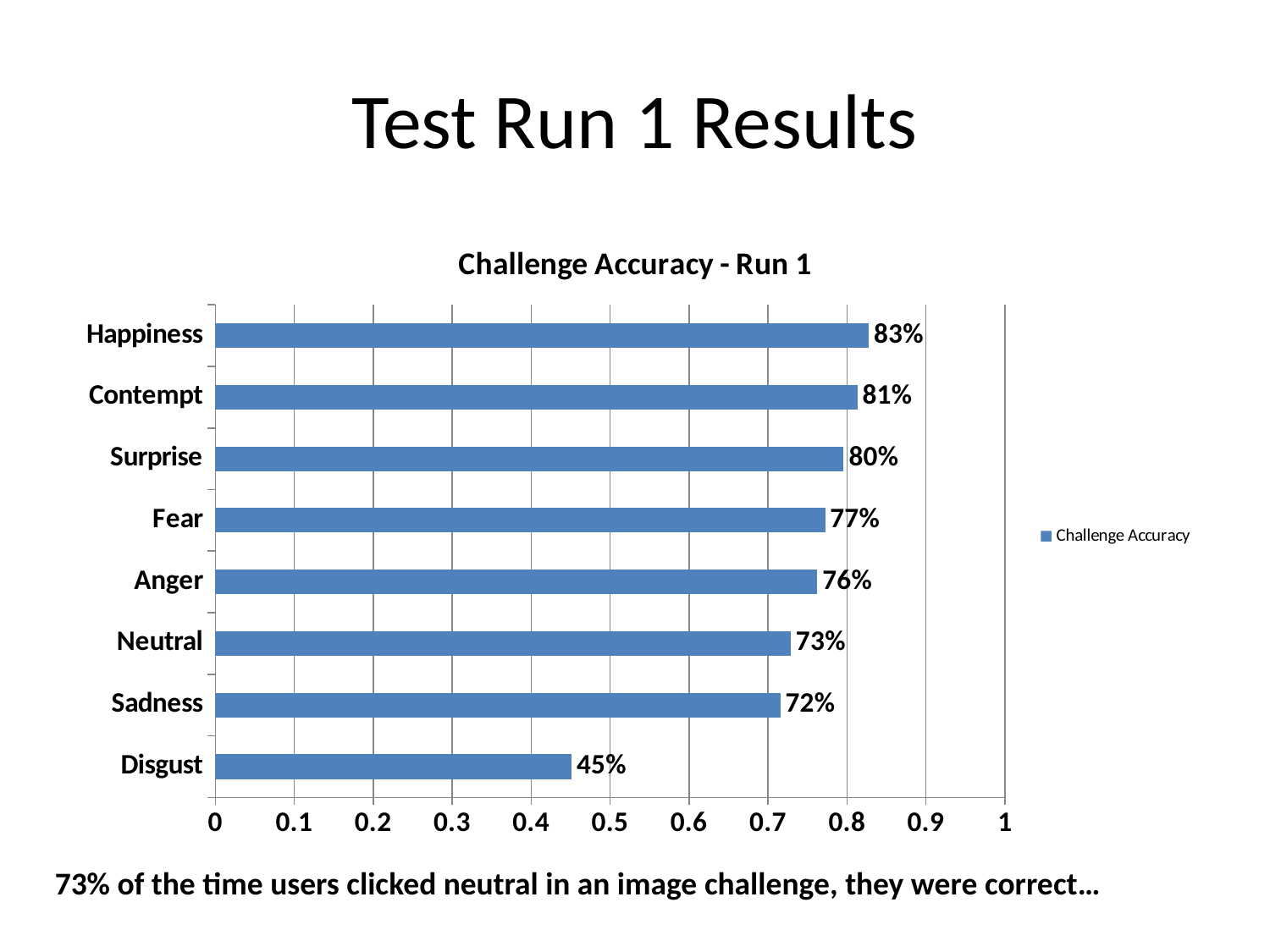
Which emotion has the highest Challenge Accuracy? Happiness What type of chart is shown on the slide? Bar chart Which has a higher Challenge Accuracy, Anger or Sadness? Anger What is the difference in Challenge Accuracy between Happiness and Disgust? 38% What is the Challenge Accuracy for Fear? 77% What is the title of the chart? Challenge Accuracy - Run 1 What is the Challenge Accuracy for Disgust? 45% What is the Challenge Accuracy for Happiness? 83% What is the difference in Challenge Accuracy between Surprise and Neutral? 7% Is the value for Disgust greater or less than 0.5? less Which emotion has the lowest Challenge Accuracy? Disgust How many emotion categories are shown in the chart? 8